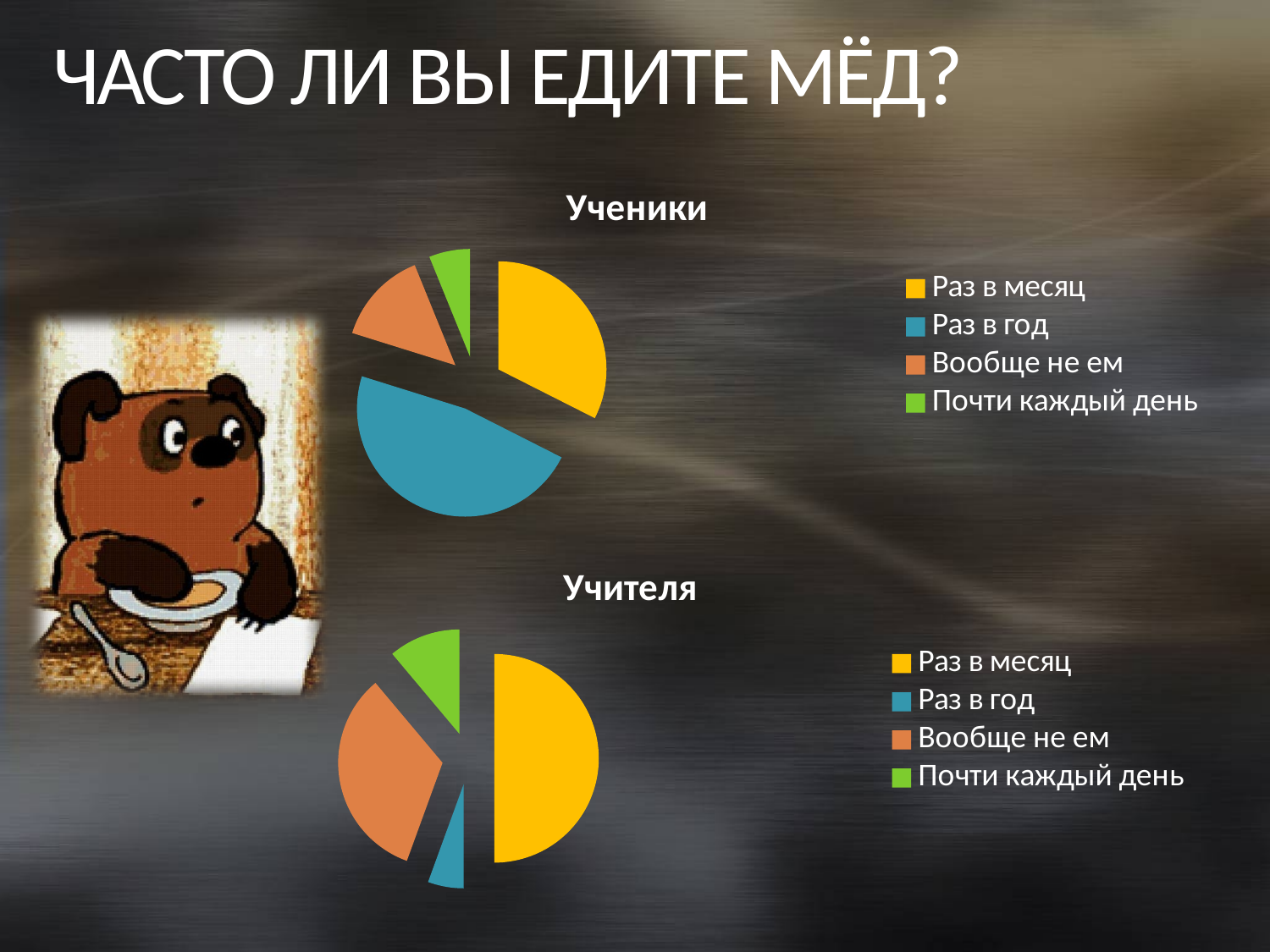
What kind of chart is the "Ученики" chart? pie chart In the "Учителя" chart, which slice is larger: "Вообще не ем" or "Раз в год"? Вообще не ем In the "Учителя" chart, which category has the smallest slice? Раз в год In the "Ученики" chart, which category has the smallest slice? Почти каждый день In the "Ученики" chart, which category has the largest slice? Раз в год How many entries does the legend of the "Учителя" chart list? 4 What is the title of the upper pie chart? Ученики In the "Учителя" chart, which colour represents "Почти каждый день"? green What kind of chart is the "Учителя" chart? pie chart In the "Учителя" chart, which category has the largest slice? Раз в месяц How many slices does the "Ученики" pie chart have? 4 In the "Ученики" chart, which slice is larger: "Раз в месяц" or "Вообще не ем"? Раз в месяц